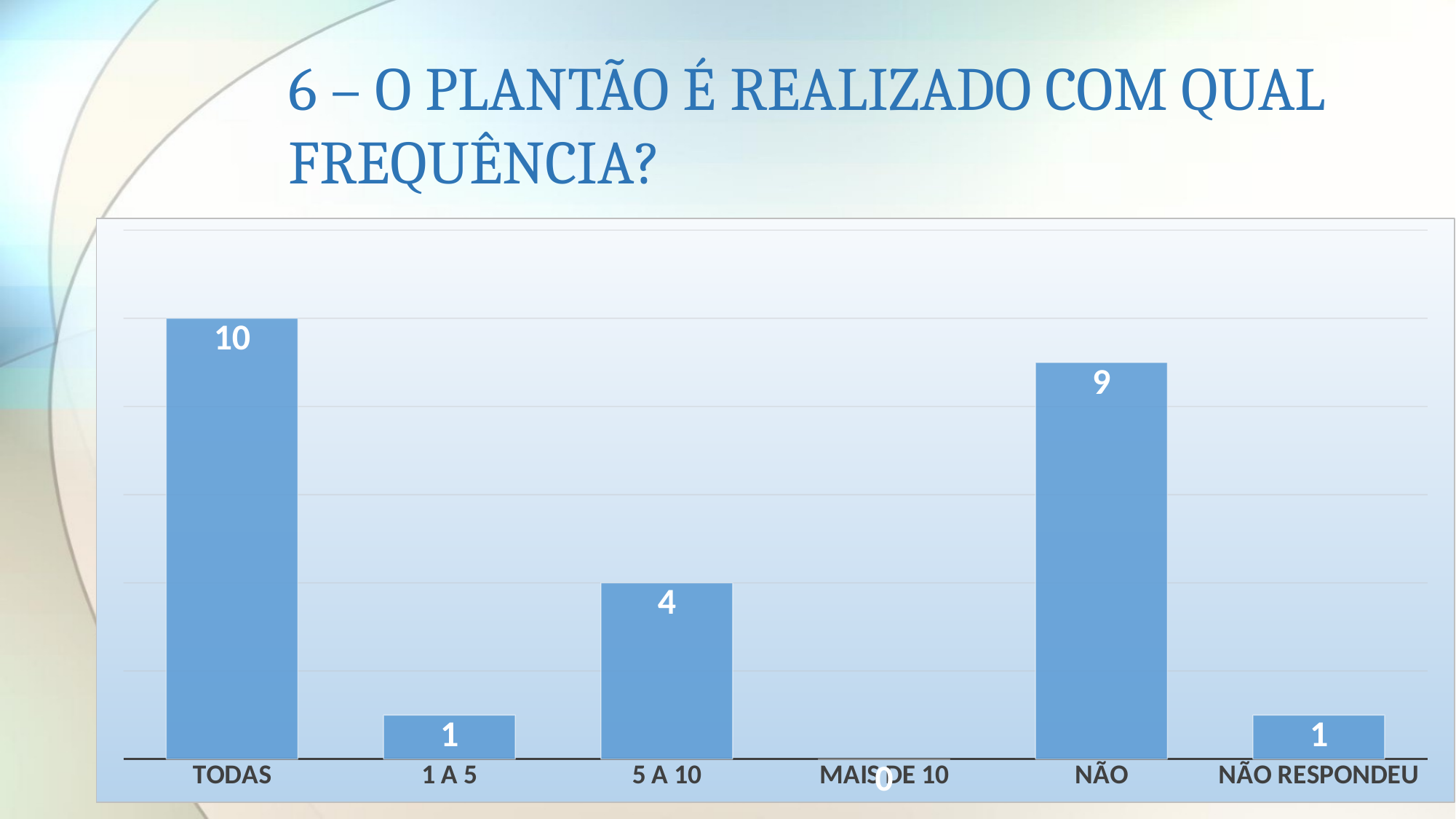
What is the title of the slide? 6 – O PLANTÃO É REALIZADO COM QUAL FREQUÊNCIA? What is the difference between the values for TODAS and NÃO? 1 What kind of chart is shown on the slide? Bar chart What is the value for NÃO? 9 What is the value for TODAS? 10 Which category has the lowest value? MAIS DE 10 Which category has the highest value? TODAS What is the value for MAIS DE 10? 0 What is the value for 5 A 10? 4 Which is larger, the value for 5 A 10 or the value for 1 A 5? 5 A 10 What is the difference between the values for NÃO and 5 A 10? 5 How many categories are shown on the x axis? 6